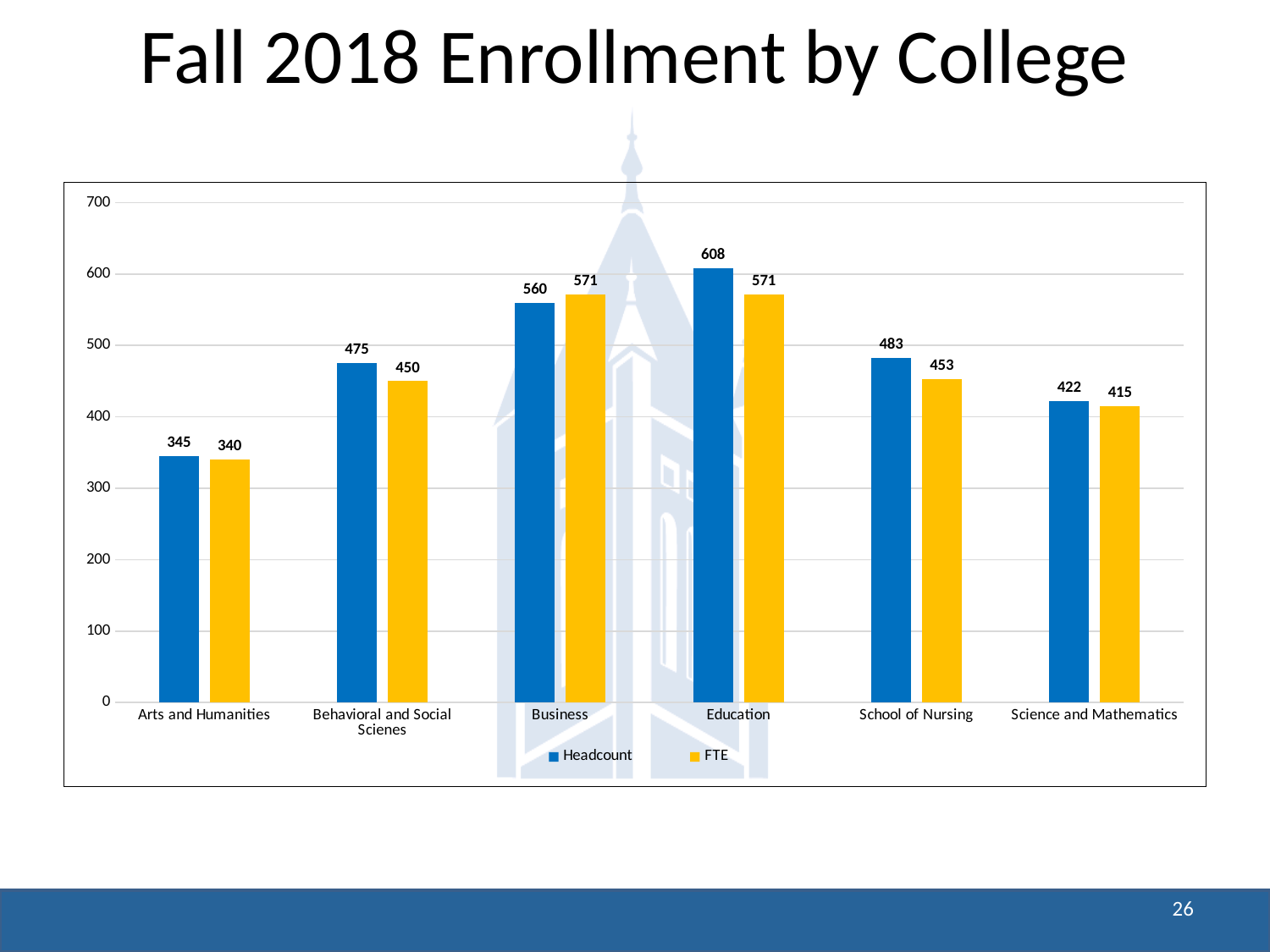
Which college has the highest Headcount? Education What is the difference in Headcount between Behavioral and Social Scienes and Science and Mathematics? 53 What kind of chart is shown on the slide? Bar chart What colour are the FTE bars? Yellow What is the FTE for School of Nursing? 453 Which college has the lowest FTE? Arts and Humanities What is the Headcount for Business? 560 How many colleges are shown on the x axis? 6 How many series does the legend list? 2 Which is larger for Business, Headcount or FTE? FTE What is the difference between Headcount and FTE for Education? 37 What is the Headcount for Arts and Humanities? 345